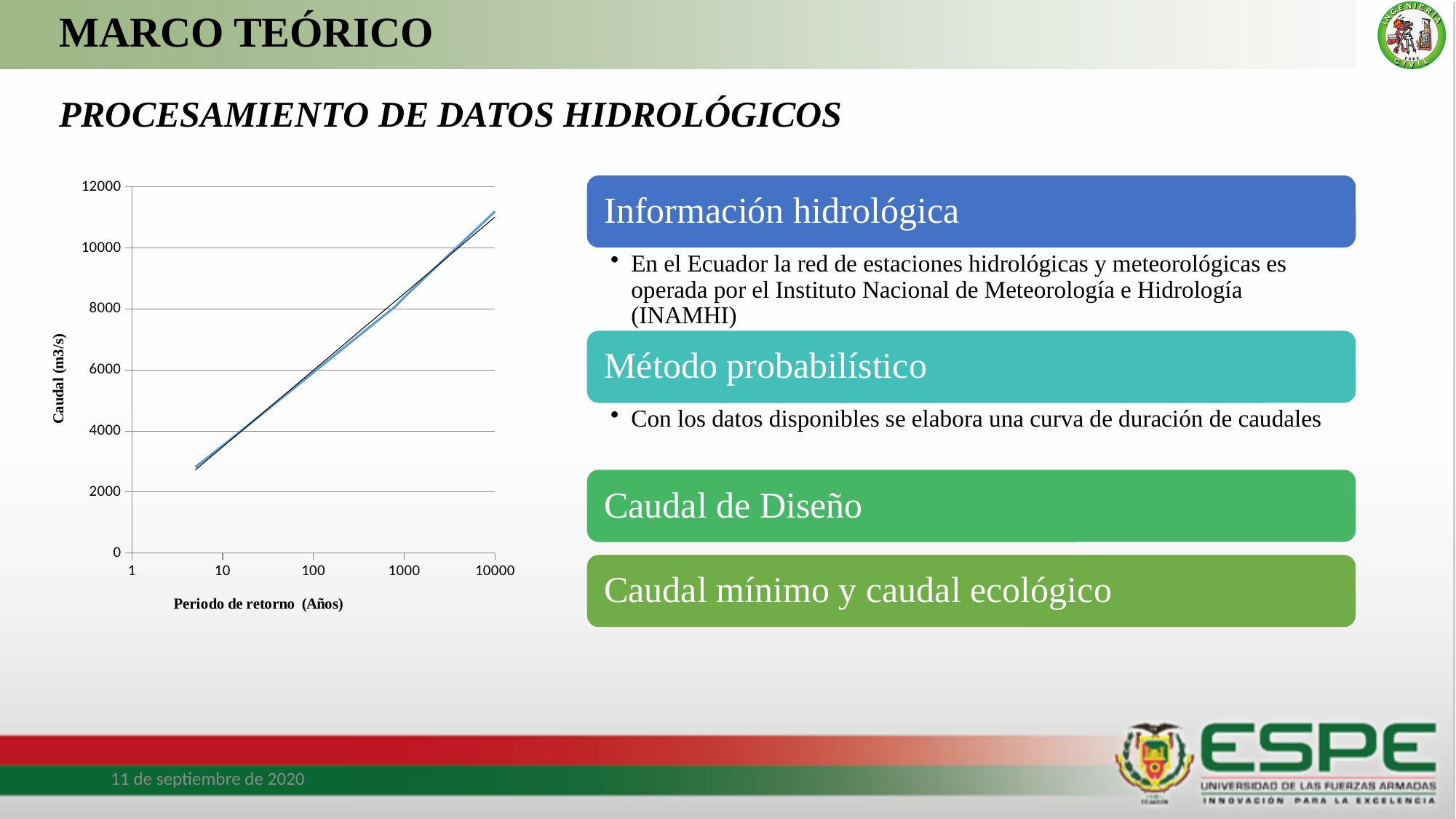
Is the caudal value at a periodo de retorno of 100 años greater or less than 4000? greater Is the caudal value at a periodo de retorno of 100 años greater or less than 8000? less What is the highest value shown on the y axis of the chart? 12000 What kind of chart is shown on the slide? line chart What is the title of the y axis of the chart? Caudal (m3/s) Is the caudal value at a periodo de retorno of 1000 años greater or less than 6000? greater What is the title of the x axis of the chart? Periodo de retorno (Años) Does the caudal rise or fall as the periodo de retorno increases along the x axis? rise